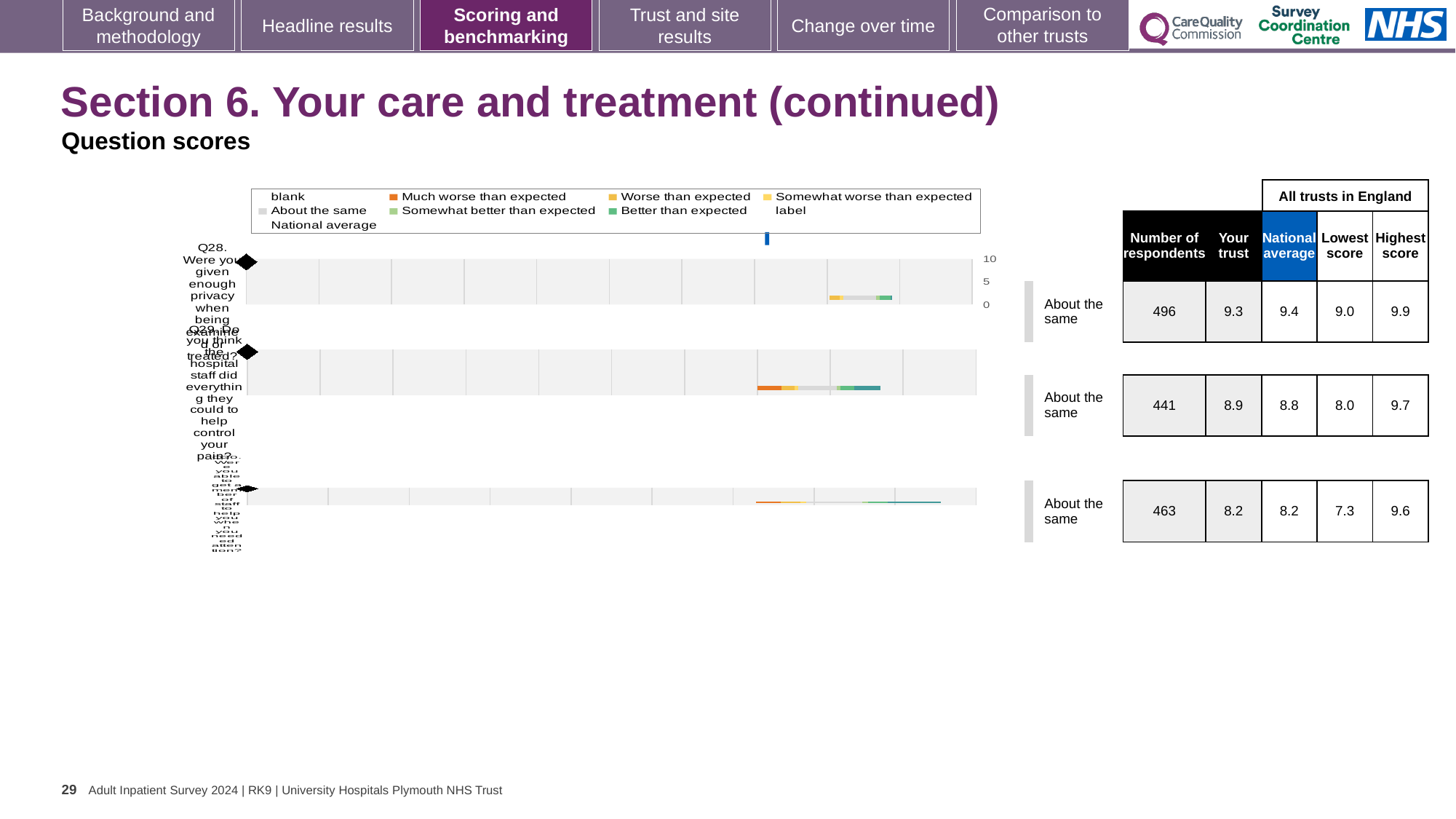
What is the difference between the highest score and the lowest score for Q29? 1.7 Which question has the lowest 'Your trust' score? Q30 What is the national average score for Q29 (Do you think the hospital staff did everything they could to help control your pain?)? 8.8 What is the 'Your trust' score for Q28 (Were you given enough privacy when being examined or treated?)? 9.3 How many questions are plotted in the chart? 3 What benchmark category is shown for Q29? About the same How many respondents answered Q28? 496 What is the highest score among all trusts in England for Q29? 9.7 For Q28, which is larger: the 'Your trust' score or the national average? National average What is the lowest score among all trusts in England for the third question (Q30)? 7.3 Which question has the highest 'Your trust' score? Q28 What kind of chart is used to show the question scores on this slide? bar chart